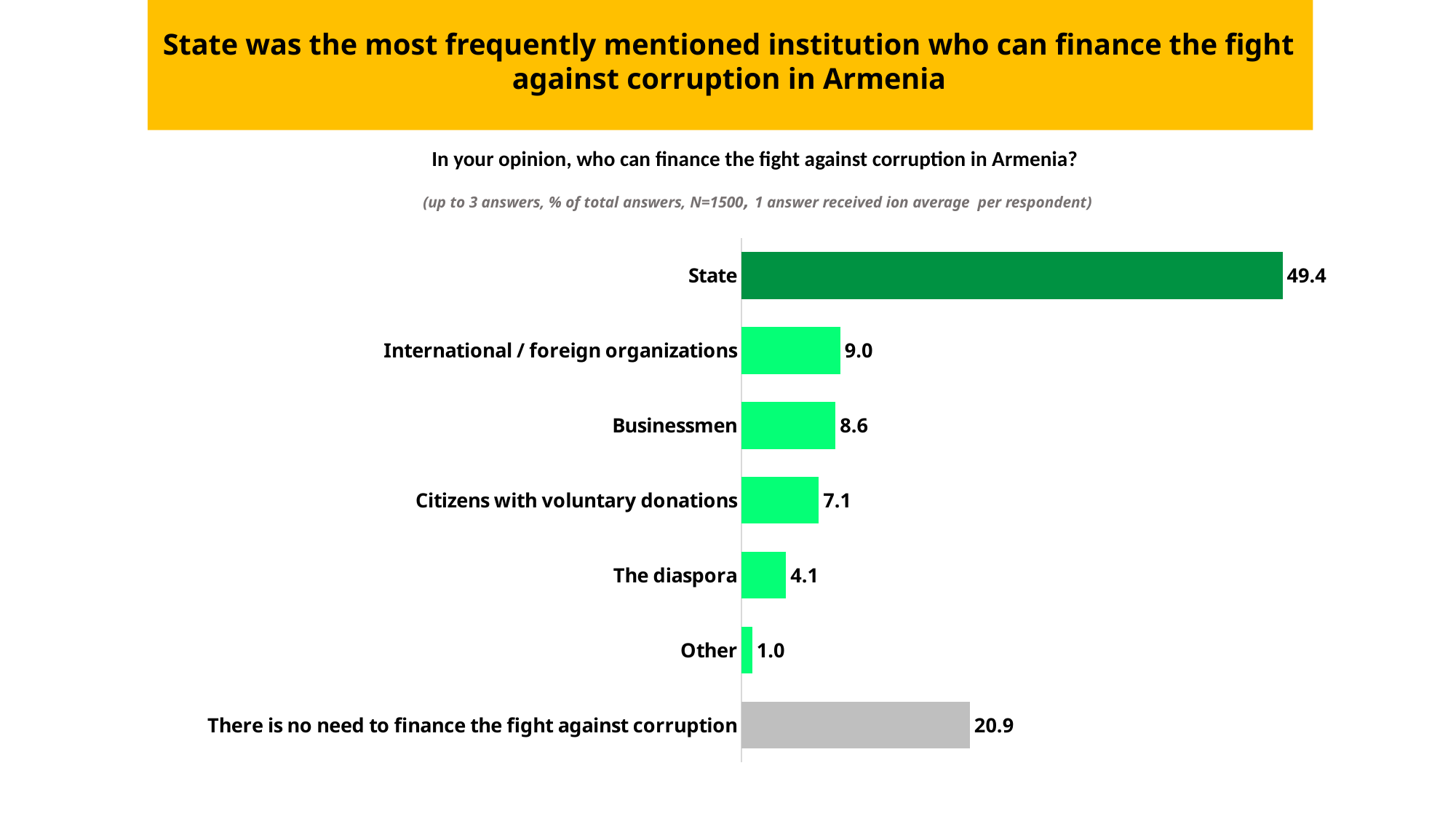
What is the value for State? 49.4 What kind of chart is shown on the slide? Bar chart Which category has the lowest value? Other How many categories are shown in the chart? 7 What is the difference between the values for Businessmen and Citizens with voluntary donations? 1.5 Which is larger, the value for Citizens with voluntary donations or the value for The diaspora? Citizens with voluntary donations What is the difference between the values for State and There is no need to finance the fight against corruption? 28.5 Which category has the highest value? State What is the survey question shown above the chart? In your opinion, who can finance the fight against corruption in Armenia? What is the value for There is no need to finance the fight against corruption? 20.9 What is the value for The diaspora? 4.1 What is the value for International / foreign organizations? 9.0